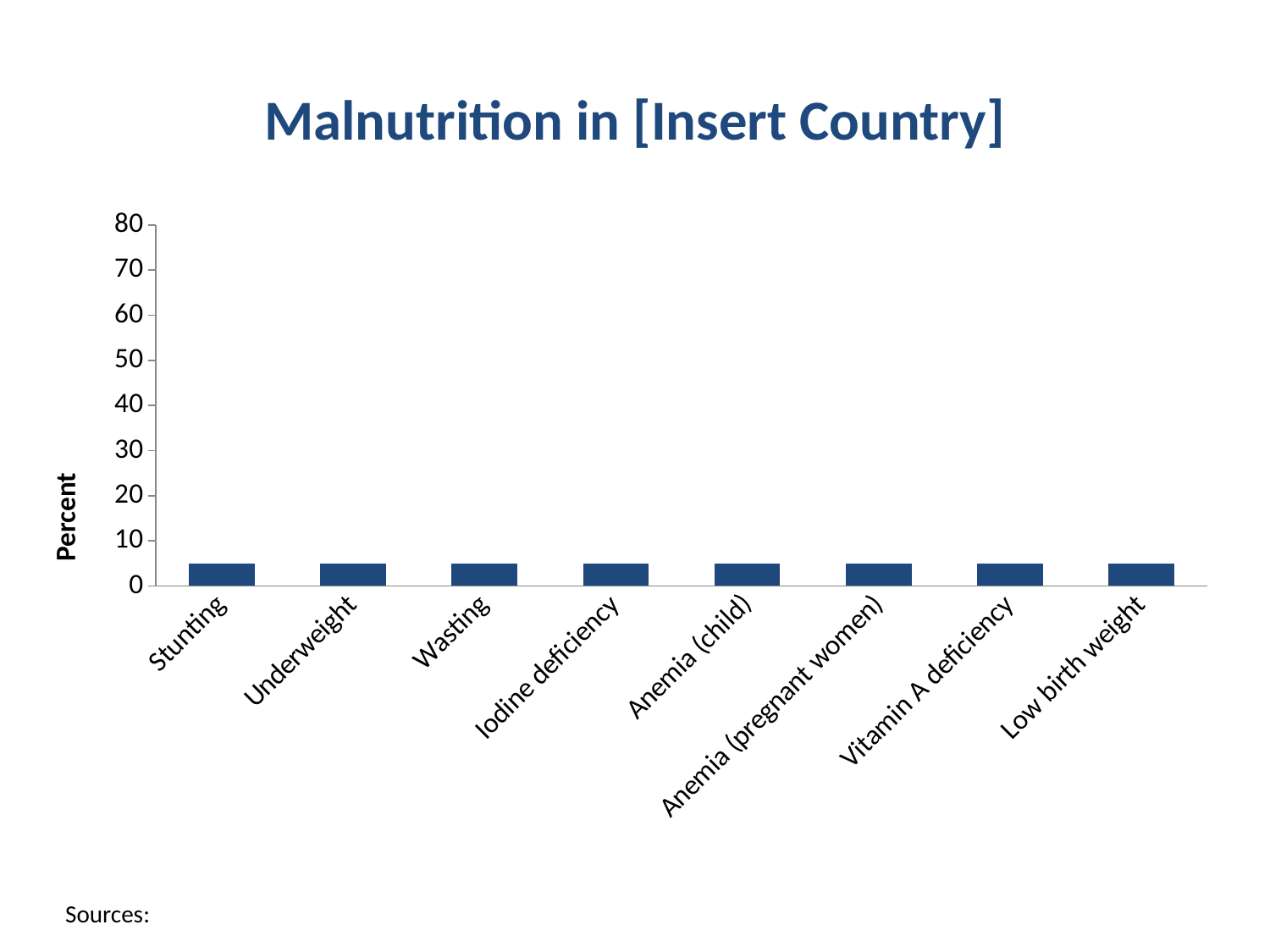
Is the value for Wasting greater or less than 40? less Do the bar values rise, fall, or stay flat moving from Stunting to Low birth weight along the x axis? stay flat Is the value for Low birth weight greater or less than 10? less What kind of chart is shown on the slide? bar chart Is the value for Stunting greater or less than 10? less What is the label on the vertical axis of the chart? Percent How many categories are shown on the x axis of the chart? 8 What is the title of the chart? Malnutrition in [Insert Country]